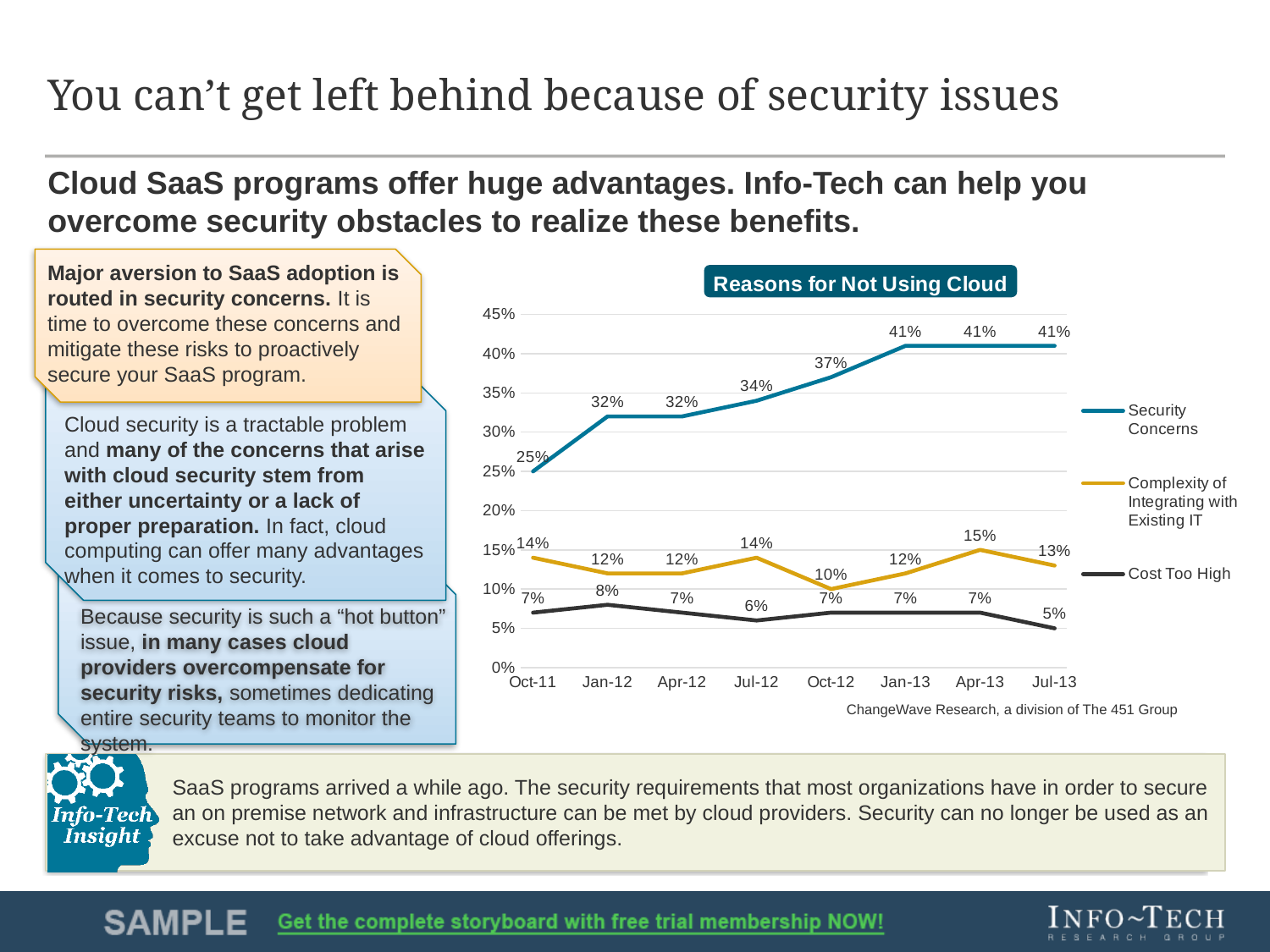
What is the value for Security Concerns in Oct-12? 37% At which time point is Security Concerns lowest? Oct-11 What is the value for Cost Too High in Jul-13? 5% Does the Security Concerns series generally rise or fall from Oct-11 to Jul-13? Rise What is the difference between the Security Concerns values in Jul-13 and Oct-11? 16% How many time points are plotted along the x axis? 8 What is the value for Complexity of Integrating with Existing IT in Apr-13? 15% What type of chart is shown on the slide? Line chart What is the title of the chart? Reasons for Not Using Cloud Which is larger in Jan-12: Complexity of Integrating with Existing IT or Cost Too High? Complexity of Integrating with Existing IT How many series does the chart's legend list? 3 At which time point is Complexity of Integrating with Existing IT highest? Apr-13